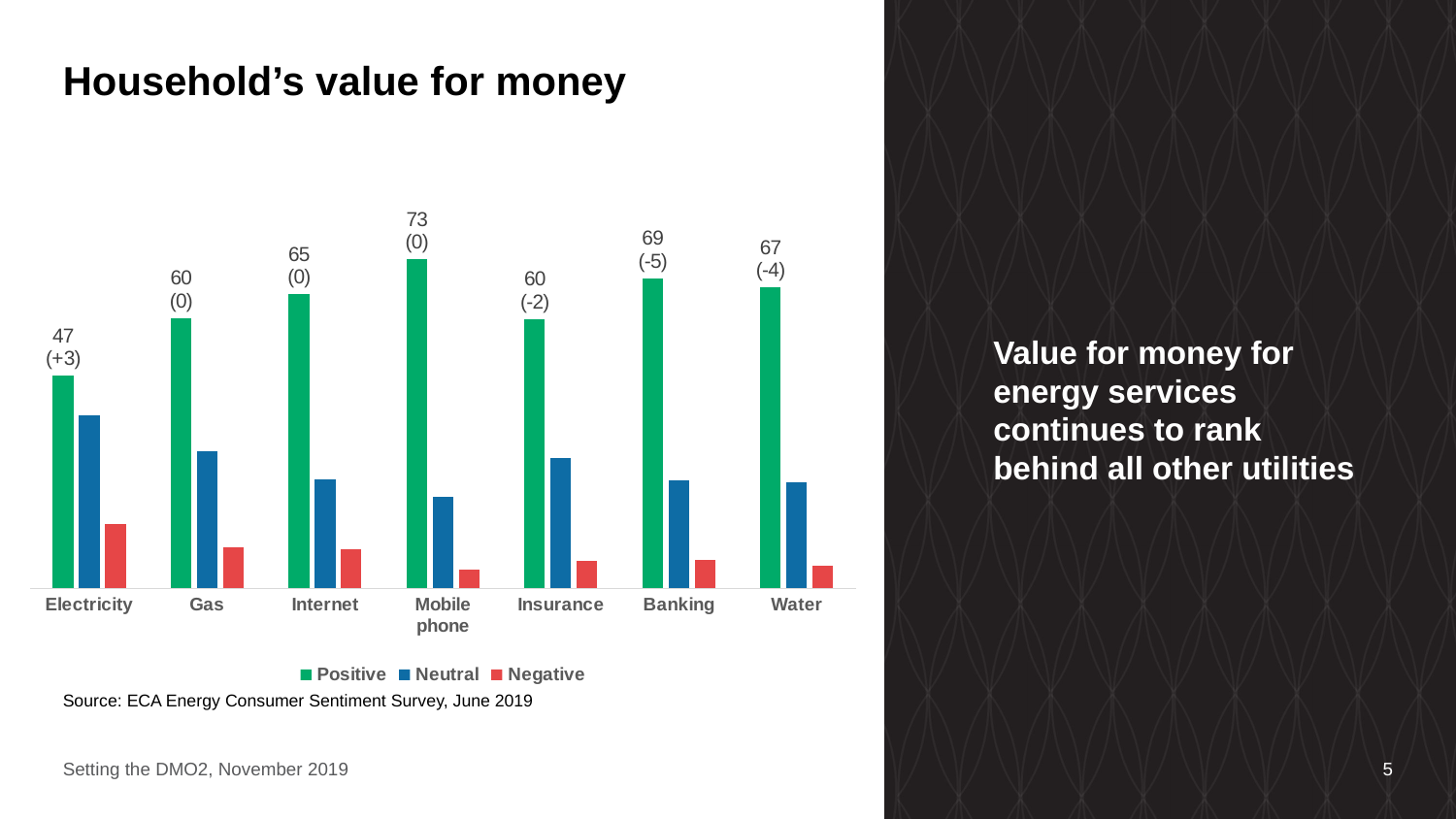
What is the Positive value for Electricity? 47 What type of chart is shown on the slide? Bar chart Which has a larger Positive value, Water or Internet? Water What is the Positive value for Banking? 69 How many categories are shown on the x axis? 7 What change is shown in parentheses for Banking's Positive value? -5 What is the Positive value for Mobile phone? 73 Which colour represents the Negative series in the legend? Red What is the difference between the Positive values for Mobile phone and Electricity? 26 Which category has the lowest Positive value? Electricity How many series does the legend list? 3 Which category has the highest Positive value? Mobile phone